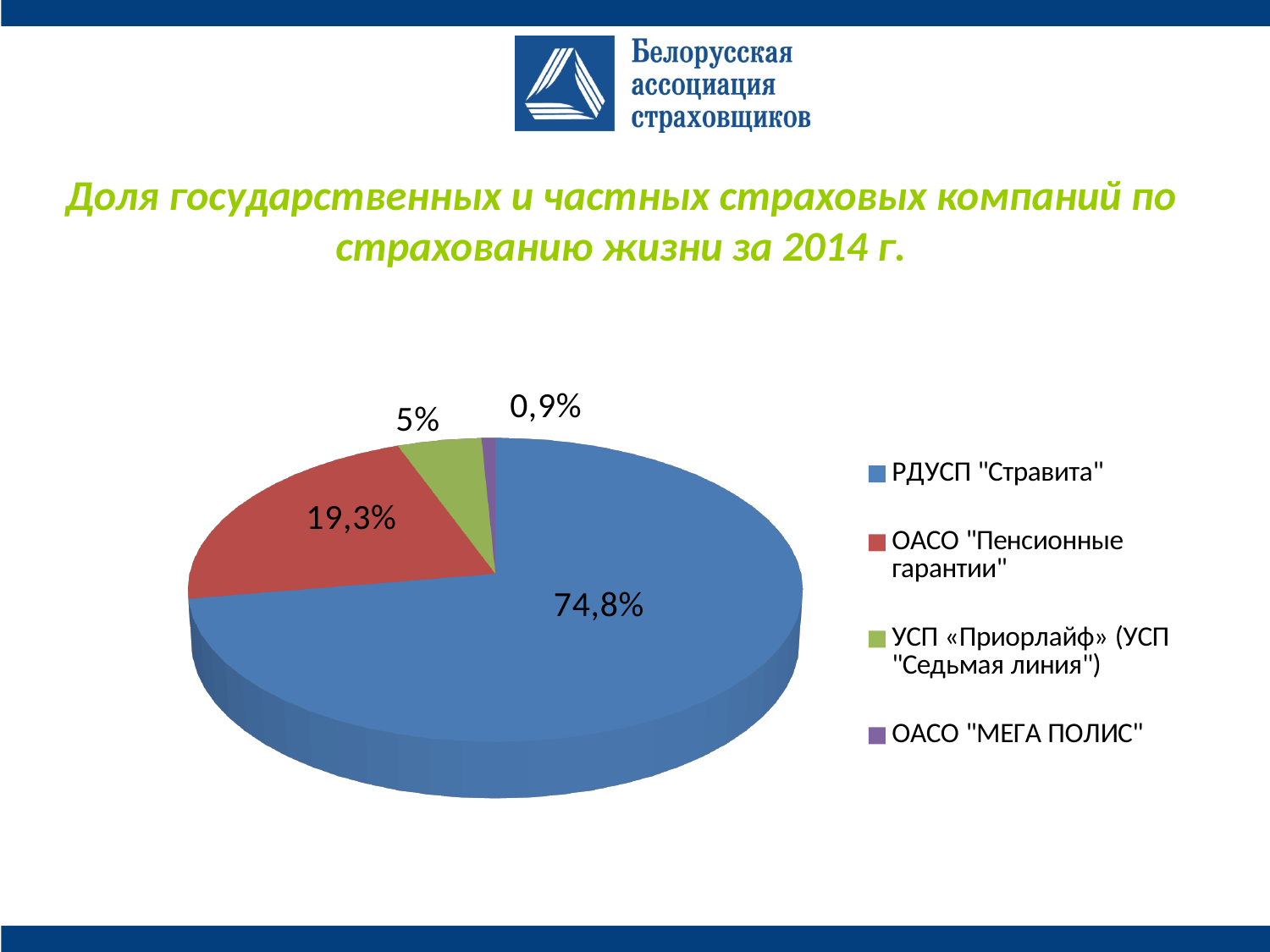
Which company has the smallest slice of the pie? ОАСО "МЕГА ПОЛИС" What share of the pie does РДУСП "Стравита" hold? 74,8% What share of the pie does ОАСО "Пенсионные гарантии" hold? 19,3% How many slices does the pie chart have? 4 What kind of chart is shown on the slide? pie chart How many entries does the legend list? 4 Which company has the largest slice of the pie? РДУСП "Стравита" Which is larger: the share of ОАСО "Пенсионные гарантии" or the share of УСП «Приорлайф» (УСП "Седьмая линия")? ОАСО "Пенсионные гарантии" What colour is the slice for ОАСО "Пенсионные гарантии"? red What is the difference between the shares of РДУСП "Стравита" and ОАСО "Пенсионные гарантии"? 55,5% What share of the pie does ОАСО "МЕГА ПОЛИС" hold? 0,9% What share of the pie does УСП «Приорлайф» (УСП "Седьмая линия") hold? 5%